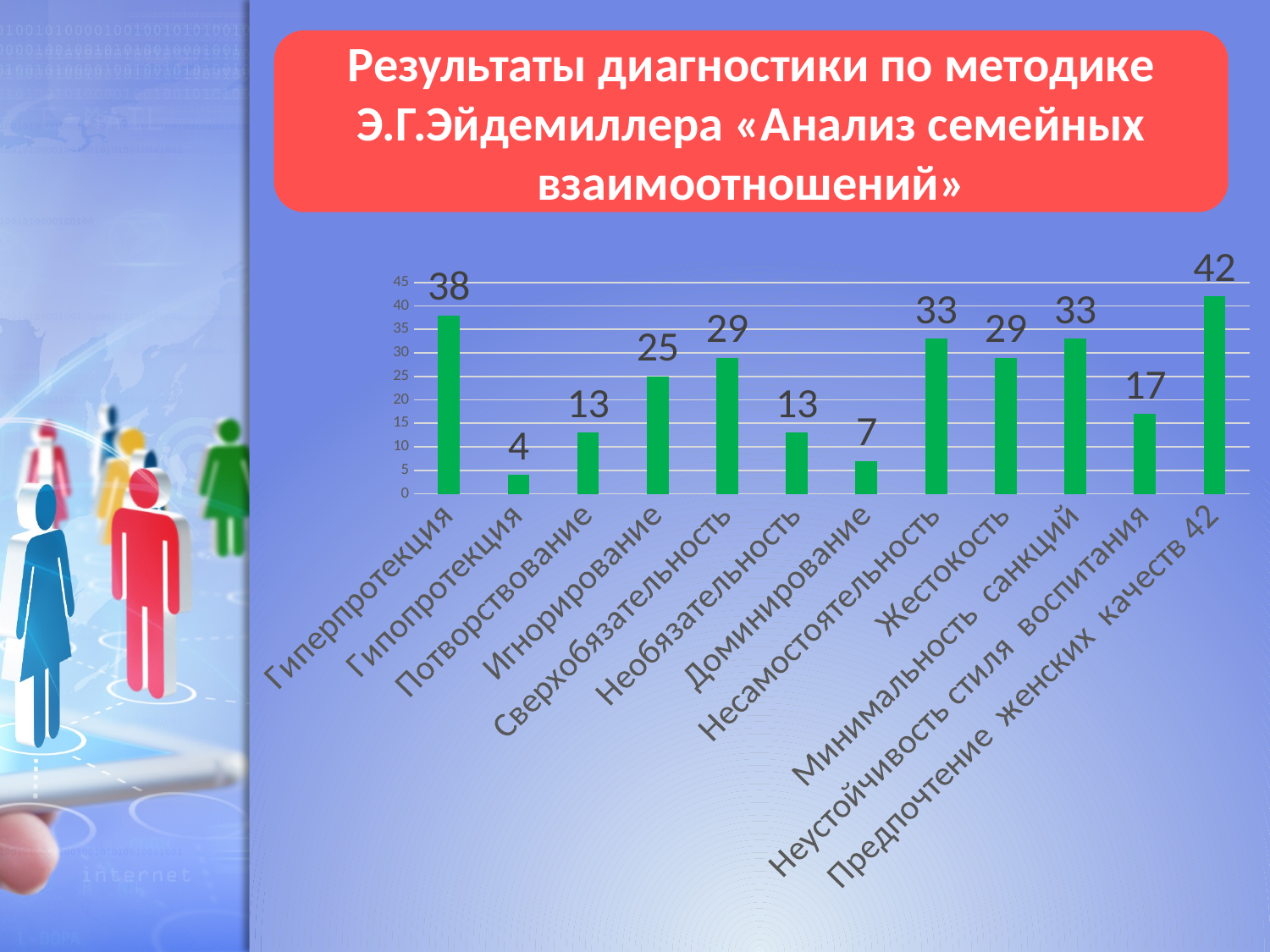
What is the difference between the values for Несамостоятельность and Жестокость? 4 What kind of chart is shown on the slide? Bar chart What is the value for Игнорирование? 25 Which category has the lowest value? Гипопротекция What is the value for Гиперпротекция? 38 What is the value for Доминирование? 7 What is the difference between the values for Гиперпротекция and Гипопротекция? 34 Which is larger, the value for Сверхобязательность or the value for Необязательность? Сверхобязательность What is the value for Неустойчивость стиля воспитания? 17 How many categories are shown in the chart? 12 Which category has the highest value? Предпочтение женских качеств What colour are the bars in the chart? Green